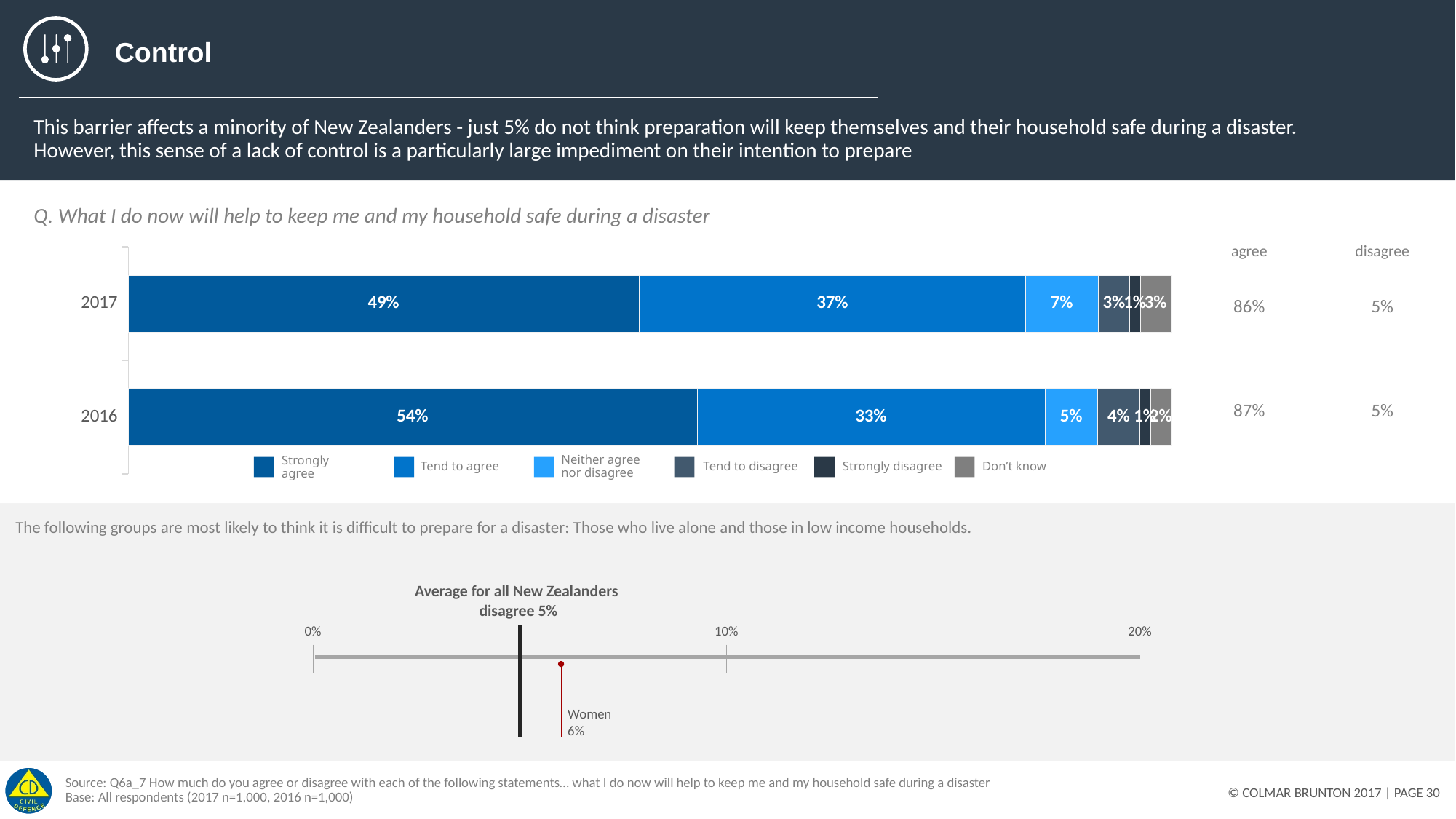
In the lower chart, what is the disagree percentage for Women? 6% In the stacked bar chart, which year has the higher 'Strongly agree' percentage, 2017 or 2016? 2016 In the stacked bar chart, what is the difference between the 'Strongly agree' values for 2016 and 2017? 5% According to the summary column next to the stacked bar chart, what is the total 'agree' percentage for 2017? 86% What type of chart is used to show the 2017 and 2016 responses? Stacked bar chart In the stacked bar chart, what is the 'Tend to disagree' value for 2016? 4% How many years are shown in the stacked bar chart? 2 How many series does the legend of the stacked bar chart list? 6 In the stacked bar chart, what is the 'Neither agree nor disagree' value for 2017? 7% In the stacked bar chart, what percentage of respondents strongly agreed in 2017? 49% In the stacked bar chart, what percentage of respondents tended to agree in 2016? 33% In the lower chart, what is the average disagree percentage for all New Zealanders? 5%